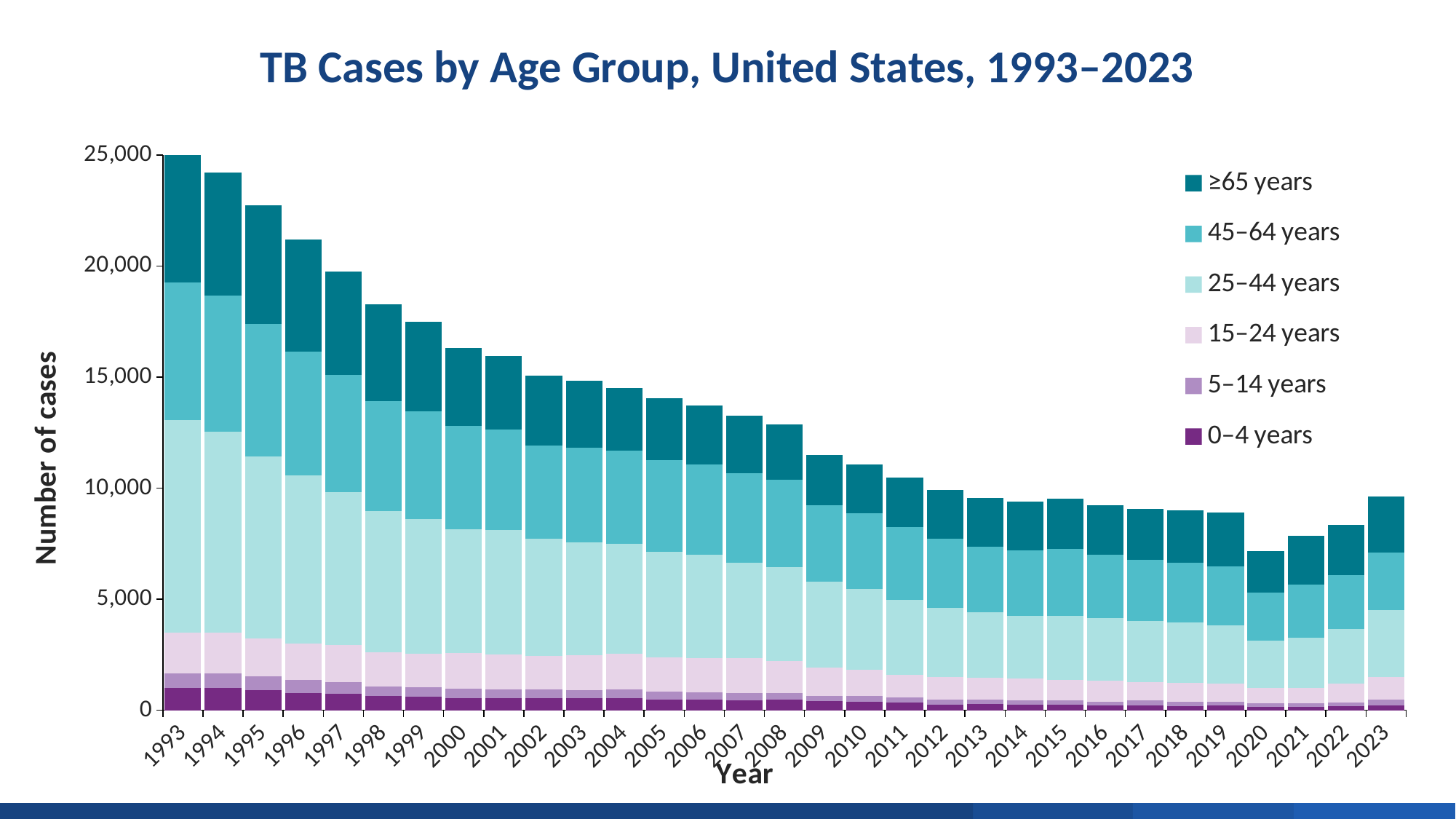
How many age groups does the legend list? 6 Is the total number of cases in 2000 greater or less than 15,000? greater Which year has a larger total number of cases, 1995 or 2005? 1995 Which year has the highest total number of TB cases? 1993 Which year has a larger total number of cases, 2020 or 2023? 2023 What kind of chart is shown on the slide? Stacked bar chart Is the total number of cases in 1993 greater or less than 20,000? greater Which year has the lowest total number of TB cases? 2020 Is the total number of cases in 2020 greater or less than 10,000? less Do total TB cases generally rise or fall from 1993 to 2019? fall What is the title of the chart? TB Cases by Age Group, United States, 1993–2023 How many years (bars) are plotted on the x axis? 31